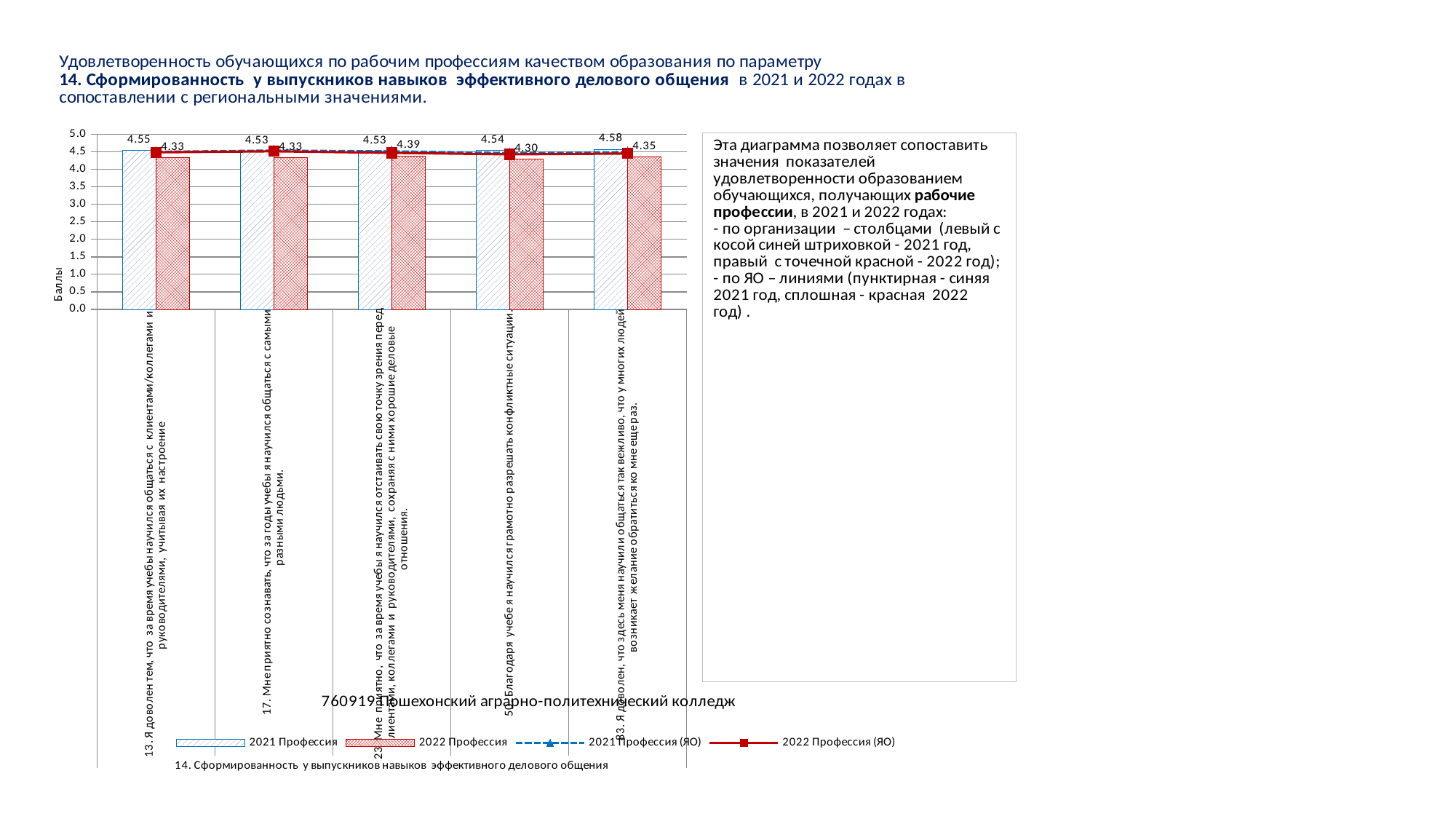
What is the label of the vertical axis of the chart? Баллы What type of chart is shown on the slide? Bar chart (with overlaid lines) Which item has the highest 2021 Профессия bar value? 83. Я доволен, что здесь меня научили общаться так вежливо (4.58) Which item has the lowest 2022 Профессия bar value? 50. Благодаря учебе я научился грамотно разрешать конфликтные ситуации (4.30) What is the difference between the 2021 Профессия and 2022 Профессия values for item 83? 0.23 How many survey items (categories) are shown on the x axis of the chart? 5 What is the value of the 2022 Профессия bar for item 50 (Благодаря учебе я научился грамотно разрешать конфликтные ситуации)? 4.30 Is the 2022 Профессия value for item 13 greater or less than 4.5? less What is the value of the 2022 Профессия bar for item 23 (Мне приятно, что за время учебы я научился отстаивать свою точку зрения)? 4.39 For item 17, which is larger: the 2021 Профессия value or the 2022 Профессия value? 2021 Профессия (4.53 vs 4.33) What is the value of the 2021 Профессия bar for item 13 (Я доволен тем, что за время учебы научился общаться с клиентами/коллегами и руководителями)? 4.55 How many series does the chart legend list? 4